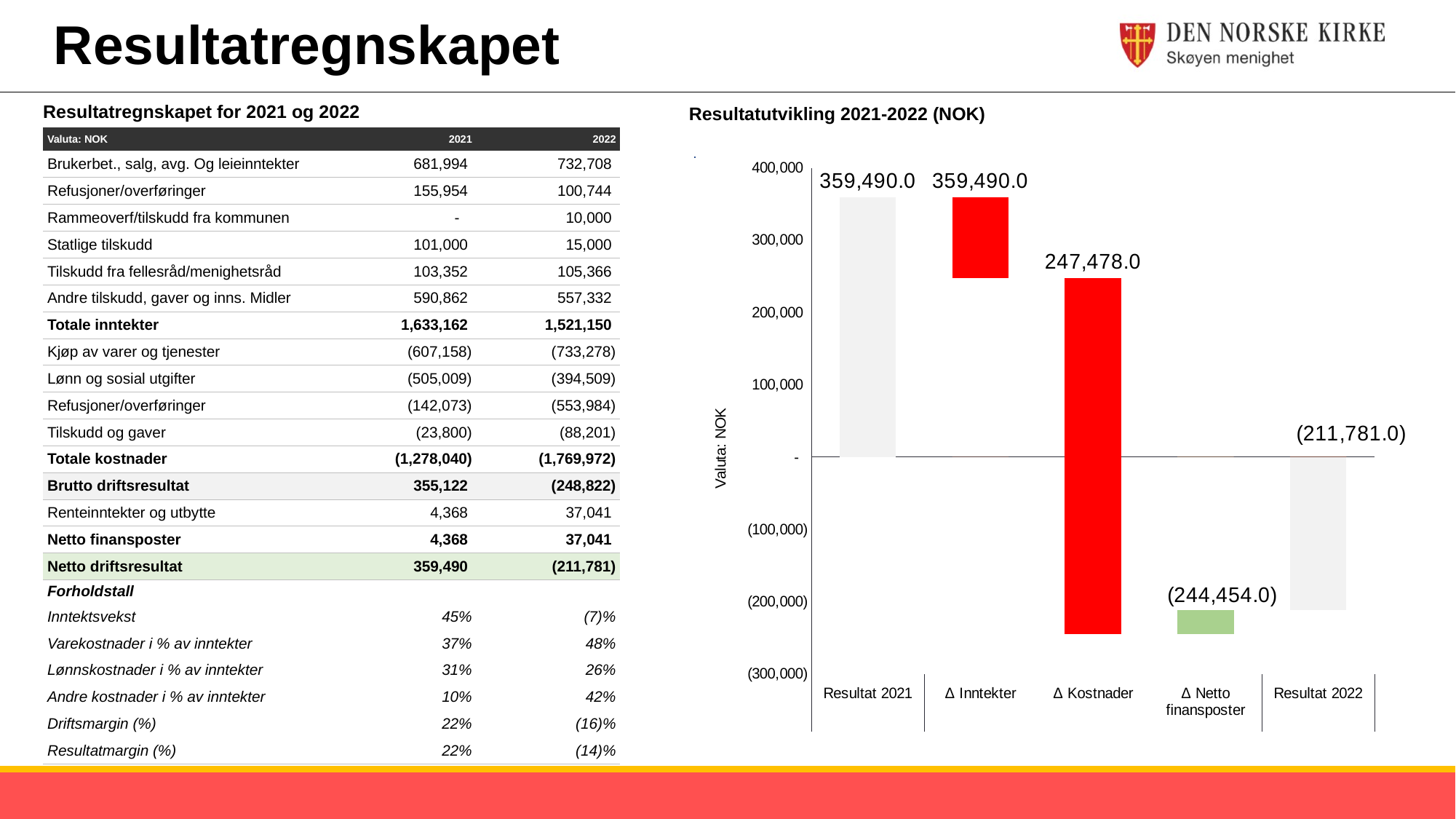
Is the bottom of the Resultat 2022 bar greater or less than (100,000)? less What is the title of the chart on the right side of the slide? Resultatutvikling 2021-2022 (NOK) Which category in the chart has the lowest data label value? Δ Netto finansposter Is the top of the Resultat 2021 bar greater or less than 300,000? greater How many categories are shown on the x axis of the chart? 5 What kind of chart is shown under the title 'Resultatutvikling 2021-2022 (NOK)'? bar chart What is the data label shown for Δ Netto finansposter in the chart? (244,454.0) What is the data label shown above the Δ Kostnader bar in the chart? 247,478.0 What is the data label shown above the Δ Inntekter bar in the chart? 359,490.0 What is the data label shown for Resultat 2021 in the chart? 359,490.0 What is the data label shown for Resultat 2022 in the chart? (211,781.0) What is the label on the vertical axis of the chart? Valuta: NOK